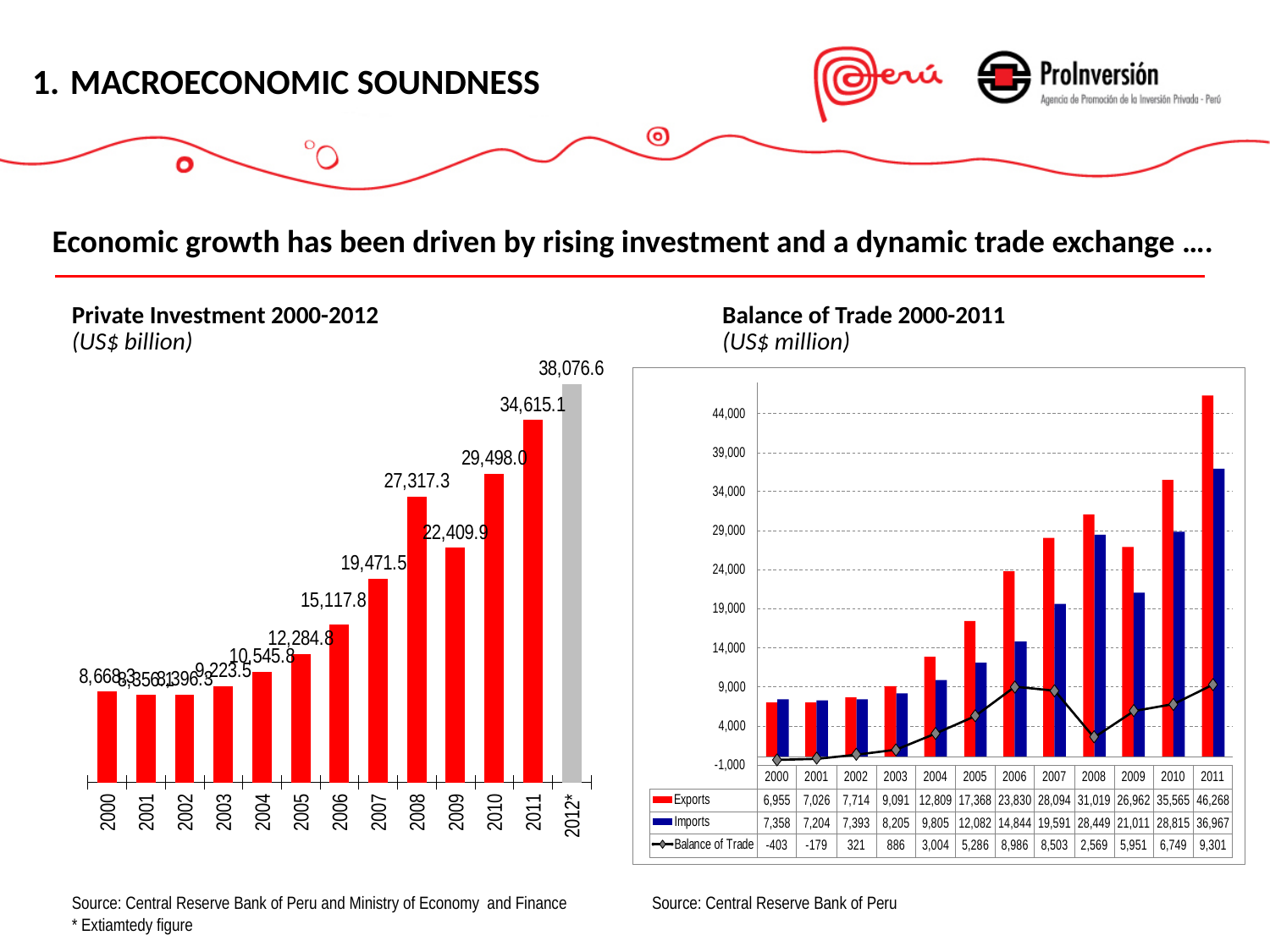
In the Balance of Trade 2000-2011 chart, in which year is the Balance of Trade lowest? 2000 What kind of chart is the Private Investment 2000-2012 chart? Bar chart In the Private Investment 2000-2012 chart, which year has the highest value? 2012* How many series does the legend of the Balance of Trade 2000-2011 chart list? 3 In the Balance of Trade 2000-2011 chart, what is the value of Imports in 2008? 28,449 How many years are shown in the Private Investment 2000-2012 chart? 13 In the Private Investment 2000-2012 chart, what is the estimated value for 2012*? 38,076.6 In the Private Investment 2000-2012 chart, what is the value for 2011? 34,615.1 In the Balance of Trade 2000-2011 chart, what is the value of Exports in 2011? 46,268 In the Private Investment 2000-2012 chart, what is the difference between the 2008 and 2009 values? 4,907.4 In the Private Investment 2000-2012 chart, which year has the larger value, 2008 or 2009? 2008 In the Balance of Trade 2000-2011 chart, in which year is the Balance of Trade highest? 2011